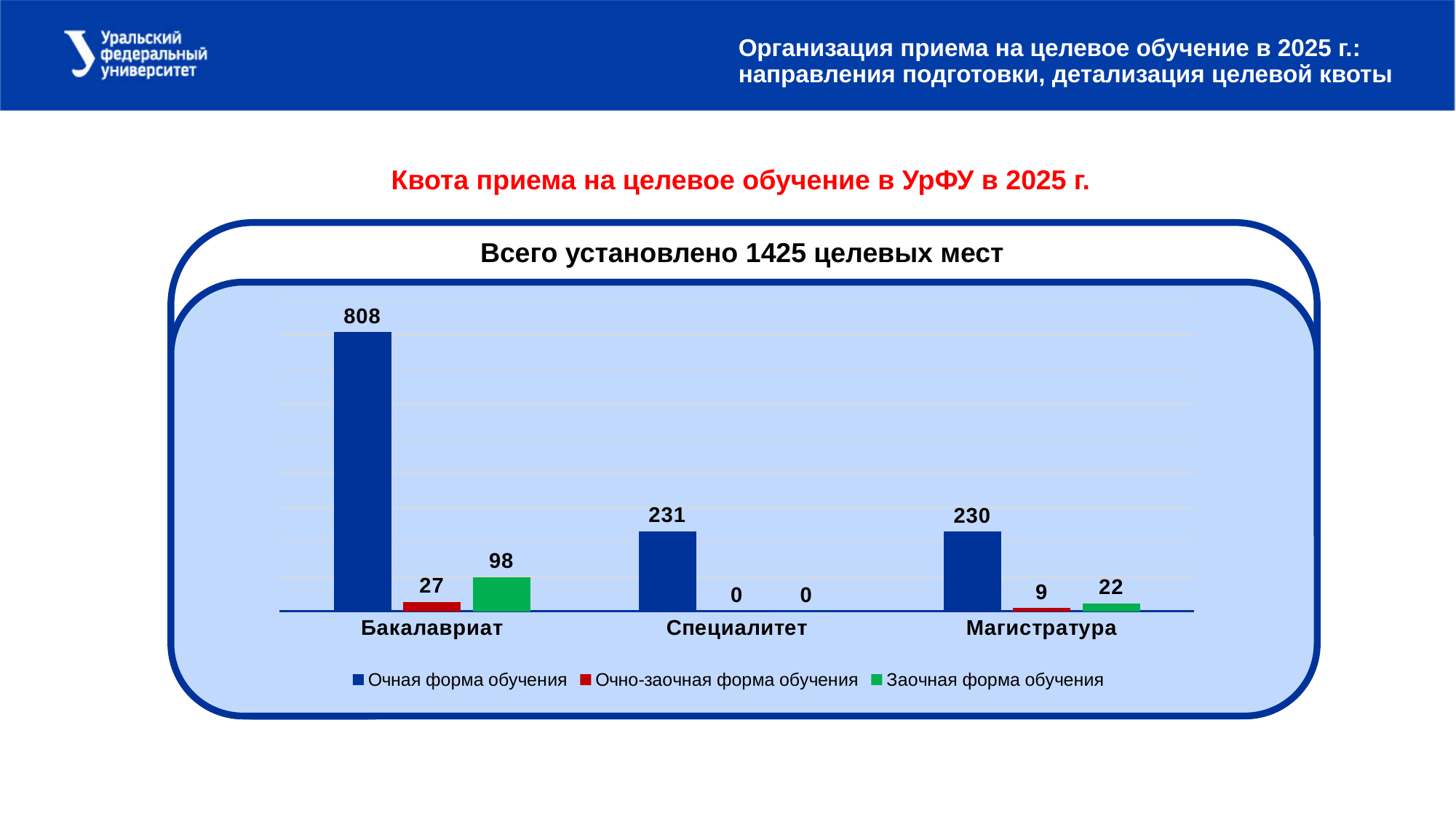
What is the value for Очная форма обучения in the Бакалавриат category? 808 How many categories are shown on the x axis? 3 Which is larger: Заочная форма обучения for Бакалавриат or Очно-заочная форма обучения for Бакалавриат? Заочная форма обучения for Бакалавриат Which category has the highest value for Очная форма обучения? Бакалавриат What is the value for Заочная форма обучения in the Магистратура category? 22 What is the value for Очно-заочная форма обучения in the Специалитет category? 0 What is the difference between the Очная форма обучения values for Бакалавриат and Специалитет? 577 What kind of chart is shown on the slide? Bar chart Which category has the lowest value for Заочная форма обучения? Специалитет What is the value for Очно-заочная форма обучения in the Бакалавриат category? 27 How many series does the legend list? 3 What is the difference between the Заочная форма обучения values for Бакалавриат and Магистратура? 76